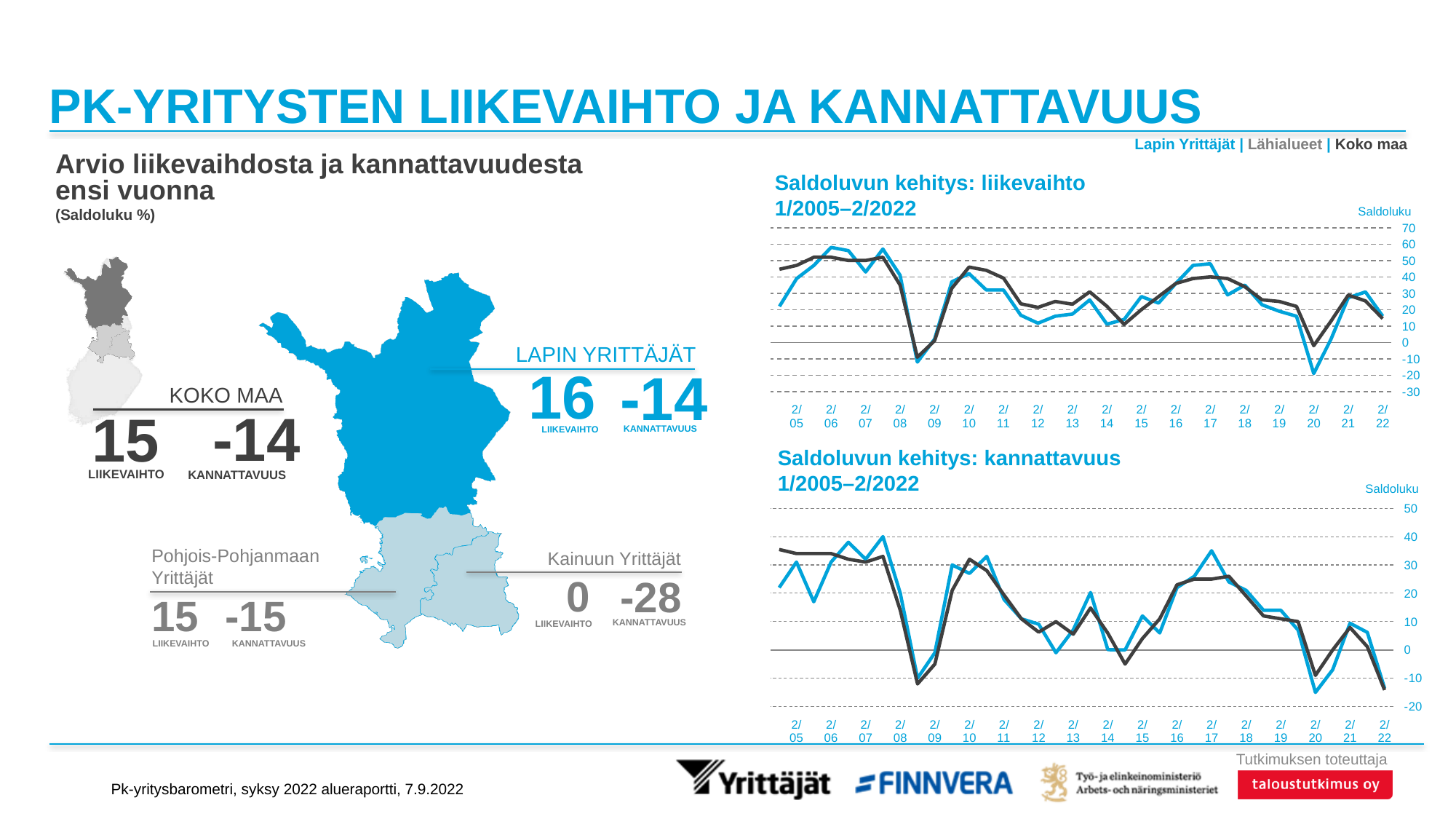
What kind of chart is 'Saldoluvun kehitys: kannattavuus 1/2005–2/2022'? Line chart In the 'Saldoluvun kehitys: kannattavuus' chart, do the values rise or fall from 2/21 to 2/22? Fall In the 'Saldoluvun kehitys: kannattavuus' chart, is the Lapin Yrittäjät (blue) value at 2/20 greater or less than -10? less In the 'Saldoluvun kehitys: liikevaihto' chart, is the Koko maa (dark) value at 2/07 greater or less than 40? greater In the 'Saldoluvun kehitys: liikevaihto' chart, how many time points are labelled on the x axis? 18 What is the label shown on the y axis of the 'Saldoluvun kehitys: liikevaihto' chart? Saldoluku In the 'Saldoluvun kehitys: liikevaihto' chart, is the Lapin Yrittäjät (blue) value at 2/20 greater or less than -10? less In the 'Saldoluvun kehitys: liikevaihto' chart, at 2/20 which series has the larger value, Lapin Yrittäjät (blue) or Koko maa (dark)? Koko maa What kind of chart is 'Saldoluvun kehitys: liikevaihto 1/2005–2/2022'? Line chart